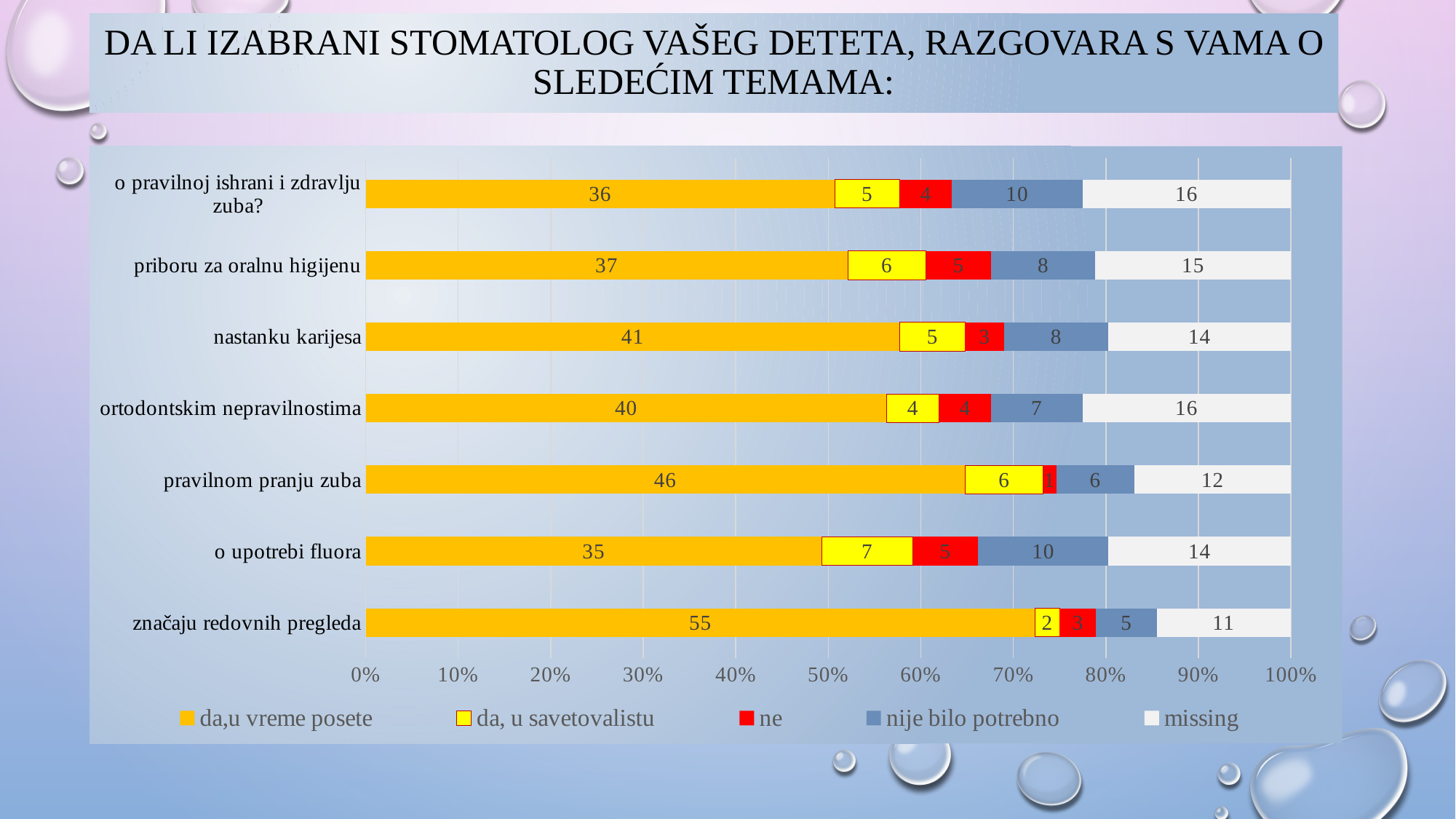
How many categories are shown on the chart? 7 Which category has the lowest "da,u vreme posete" value? o upotrebi fluora Which has the larger "nije bilo potrebno" value: "o pravilnoj ishrani i zdravlju zuba?" or "priboru za oralnu higijenu"? o pravilnoj ishrani i zdravlju zuba? What is the total of the stacked bar for "o pravilnoj ishrani i zdravlju zuba?"? 71 What is the value of "da,u vreme posete" for "značaju redovnih pregleda"? 55 How many series does the legend list? 5 What is the difference between the "da,u vreme posete" values for "nastanku karijesa" and "o upotrebi fluora"? 6 What is the "ne" value for "pravilnom pranju zuba"? 1 What is the "missing" value for "pravilnom pranju zuba"? 12 Which category has the highest "da,u vreme posete" value? značaju redovnih pregleda What colour represents the "ne" series in the legend? Red What kind of chart is shown on the slide? Stacked bar chart